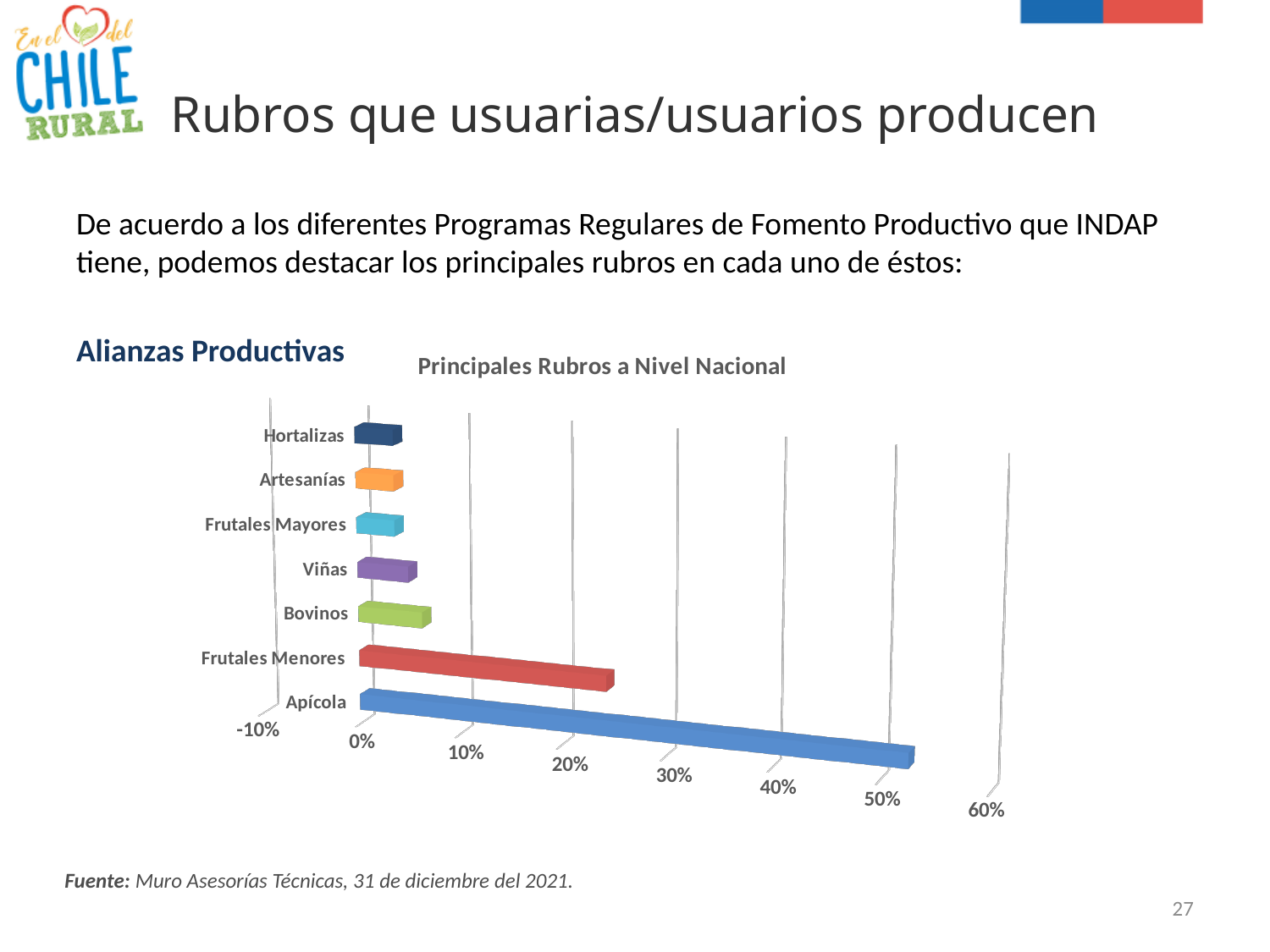
Which category is listed at the top of the chart's vertical axis? Hortalizas What is the title of the chart? Principales Rubros a Nivel Nacional Which is larger, the value for Apícola or the value for Frutales Menores? Apícola Is the value for Hortalizas greater or less than 10%? less Is the value for Frutales Menores greater or less than 10%? greater Is the value for Bovinos greater or less than 10%? less Which is larger, the value for Frutales Menores or the value for Viñas? Frutales Menores How many categories (rubros) are plotted in the chart? 7 Which category has the highest value in the chart? Apícola What type of chart is shown on the slide? Bar chart